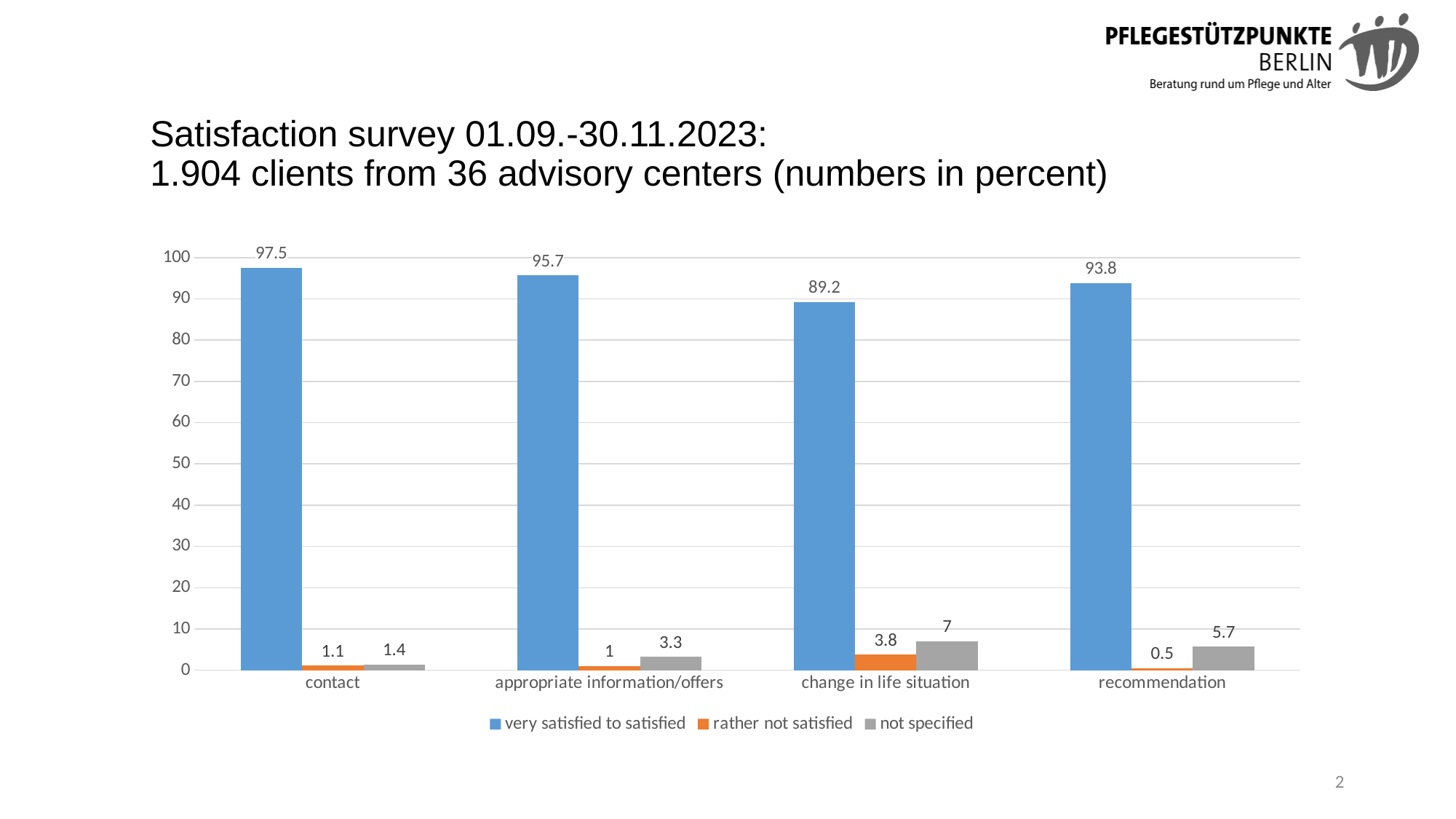
Which category has the highest value for 'very satisfied to satisfied'? contact What kind of chart is shown on the slide? bar chart Is the 'very satisfied to satisfied' value for 'recommendation' greater or less than 90? greater Which is larger: the 'not specified' value for 'appropriate information/offers' or for 'recommendation'? recommendation What is the value for 'very satisfied to satisfied' in the 'contact' category? 97.5 How many categories are shown on the x axis? 4 How many series does the legend list? 3 What is the value for 'rather not satisfied' in the 'recommendation' category? 0.5 What is the value for 'not specified' in the 'change in life situation' category? 7 Which category has the lowest value for 'very satisfied to satisfied'? change in life situation Which colour represents the 'rather not satisfied' series? orange What is the difference between the 'very satisfied to satisfied' values for 'contact' and 'change in life situation'? 8.3